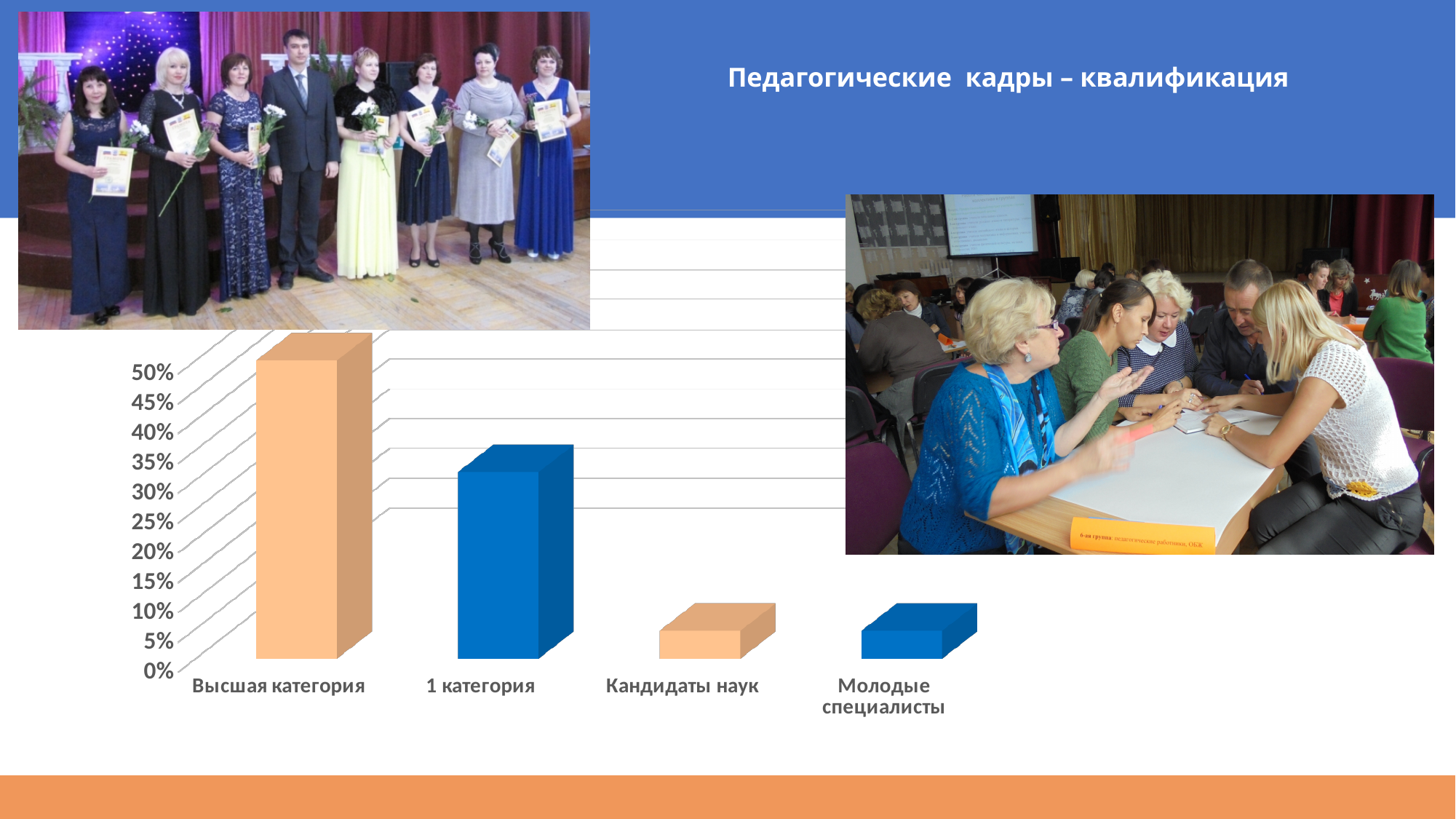
Do the values rise or fall from left to right along the x axis? fall Is the value for Высшая категория greater or less than 40%? greater What kind of chart is shown on the slide? bar chart Is the value for 1 категория greater or less than 25%? greater Which category has the highest value in the chart? Высшая категория Which is larger, the value for 1 категория or the value for Кандидаты наук? 1 категория What is the title shown on the slide above the chart? Педагогические кадры – квалификация Is the value for Молодые специалисты greater or less than 10%? less Which is larger, the value for Высшая категория or the value for 1 категория? Высшая категория How many categories are shown on the x axis of the chart? 4